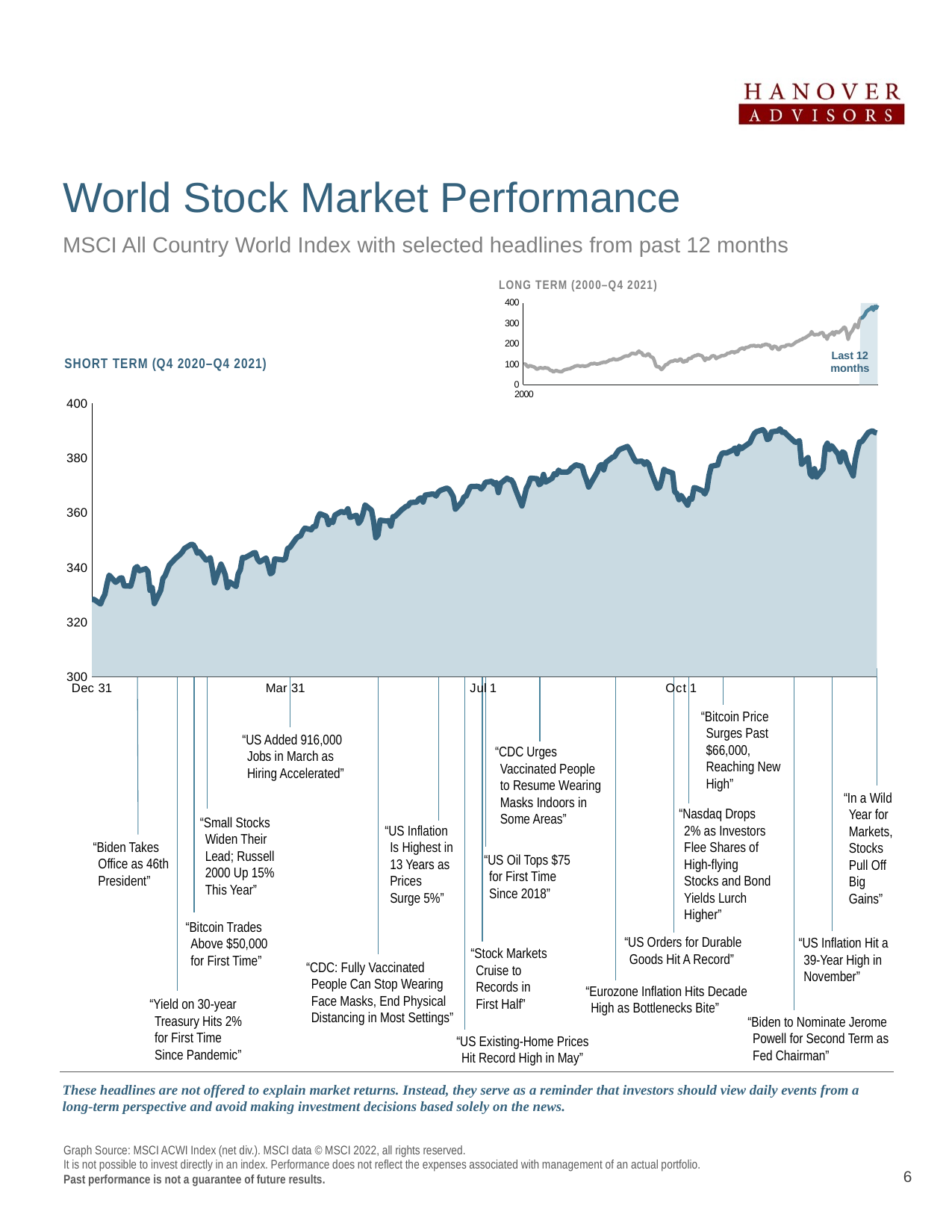
On the SHORT TERM (Q4 2020–Q4 2021) chart, does the index value generally rise or fall from Dec 31 to the end of the period? rise On the SHORT TERM (Q4 2020–Q4 2021) chart, what is the highest value shown on the y axis? 400 What kind of chart is the SHORT TERM (Q4 2020–Q4 2021) chart? line chart On the LONG TERM (2000–Q4 2021) chart, is the value at the end of the period greater or less than 300? greater On the LONG TERM (2000–Q4 2021) chart, what does the shaded region at the right end of the line represent? Last 12 months On the SHORT TERM (Q4 2020–Q4 2021) chart, is the value at the end of the period greater or less than 380? greater On the LONG TERM (2000–Q4 2021) chart, is the value at 2000 greater or less than 200? less On the LONG TERM (2000–Q4 2021) chart, does the index value rise or fall from 2000 to Q4 2021? rise On the SHORT TERM (Q4 2020–Q4 2021) chart, how many date labels are shown on the x axis? 4